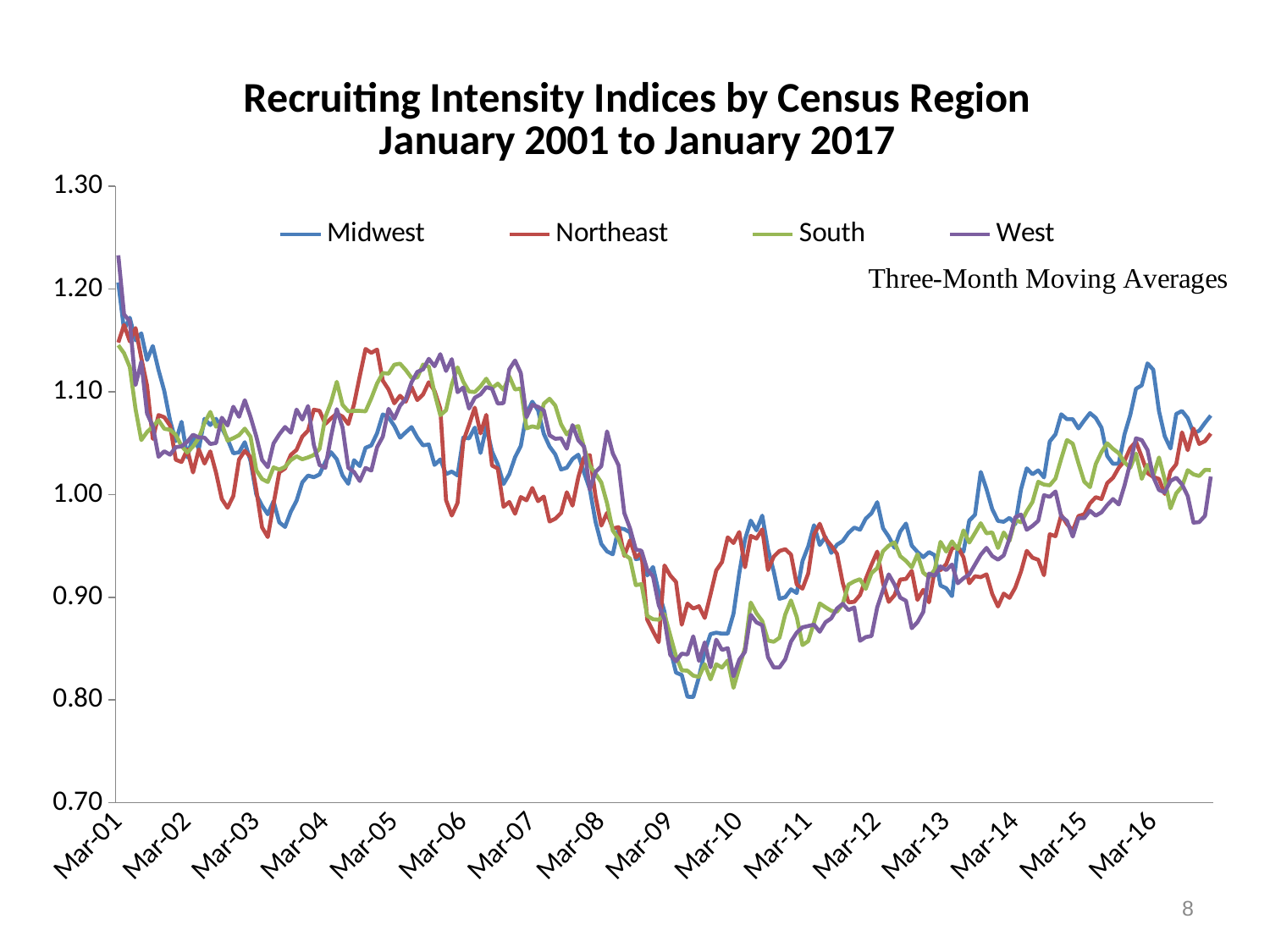
Is the value for West at Mar-10 greater or less than 0.90? less Which region has the highest value around Mar-16? Midwest What note appears below the legend describing how the series are computed? Three-Month Moving Averages Is the value for South at Mar-10 greater or less than 0.90? less What is the title of the chart? Recruiting Intensity Indices by Census Region January 2001 to January 2017 What kind of chart is shown on the slide? Line chart Which region has the highest value around Mar-10? Northeast How many series does the legend list? 4 Around Mar-11, which is higher, Northeast or West? Northeast